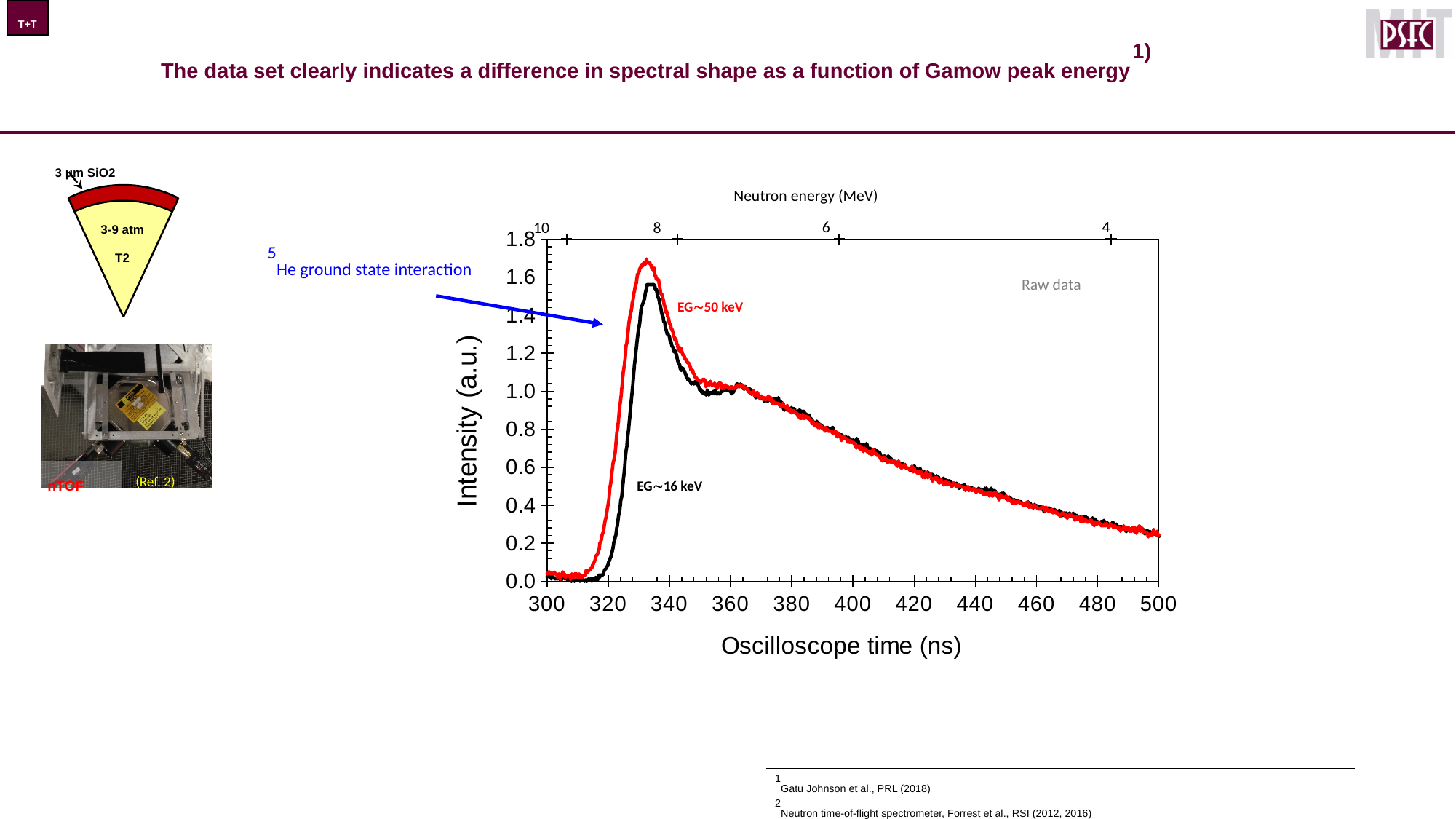
Is the intensity of the curves at 400 ns greater or less than 1.0? less What kind of chart is shown on the slide? line chart Which series reaches the higher peak intensity, EG~50 keV or EG~16 keV? EG~50 keV Is the peak value of the EG~16 keV (black) curve greater or less than 1.4? greater What is the label of the y axis of the chart? Intensity (a.u.) What is the label of the x axis of the chart? Oscilloscope time (ns) Is the intensity of the curves at 500 ns greater or less than 0.4? less Which curve begins to rise at an earlier oscilloscope time, the red EG~50 keV curve or the black EG~16 keV curve? EG~50 keV After the peak near 335 ns, do the intensity values rise or fall as oscilloscope time increases toward 500 ns? fall How many data series are plotted in the chart? 2 What is the highest oscilloscope time value shown on the x axis? 500